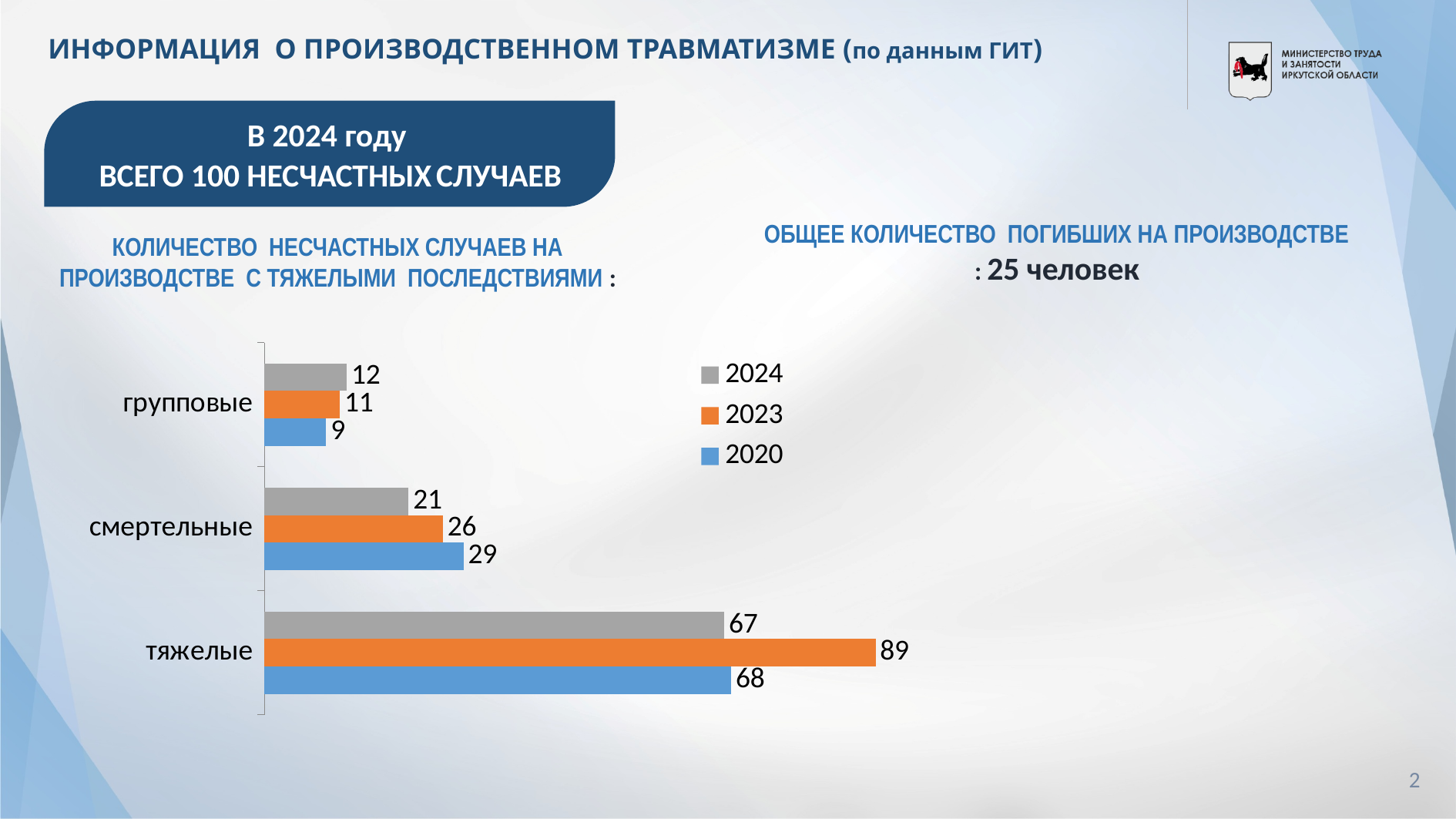
What is the difference between the 2020 and 2024 values for смертельные? 8 Which category has the lowest value in the 2023 series? групповые Which is larger for групповые: the 2024 value or the 2020 value? 2024 What kind of chart is shown on the slide? bar chart How many series does the legend list? 3 What is the value for тяжелые in the 2023 series? 89 How many categories are shown on the chart? 3 What is the difference between the 2023 and 2024 values for тяжелые? 22 Which colour represents the 2023 series in the legend? orange What is the value for групповые in the 2020 series? 9 Which category has the highest value in the 2024 series? тяжелые What is the value for смертельные in the 2024 series? 21